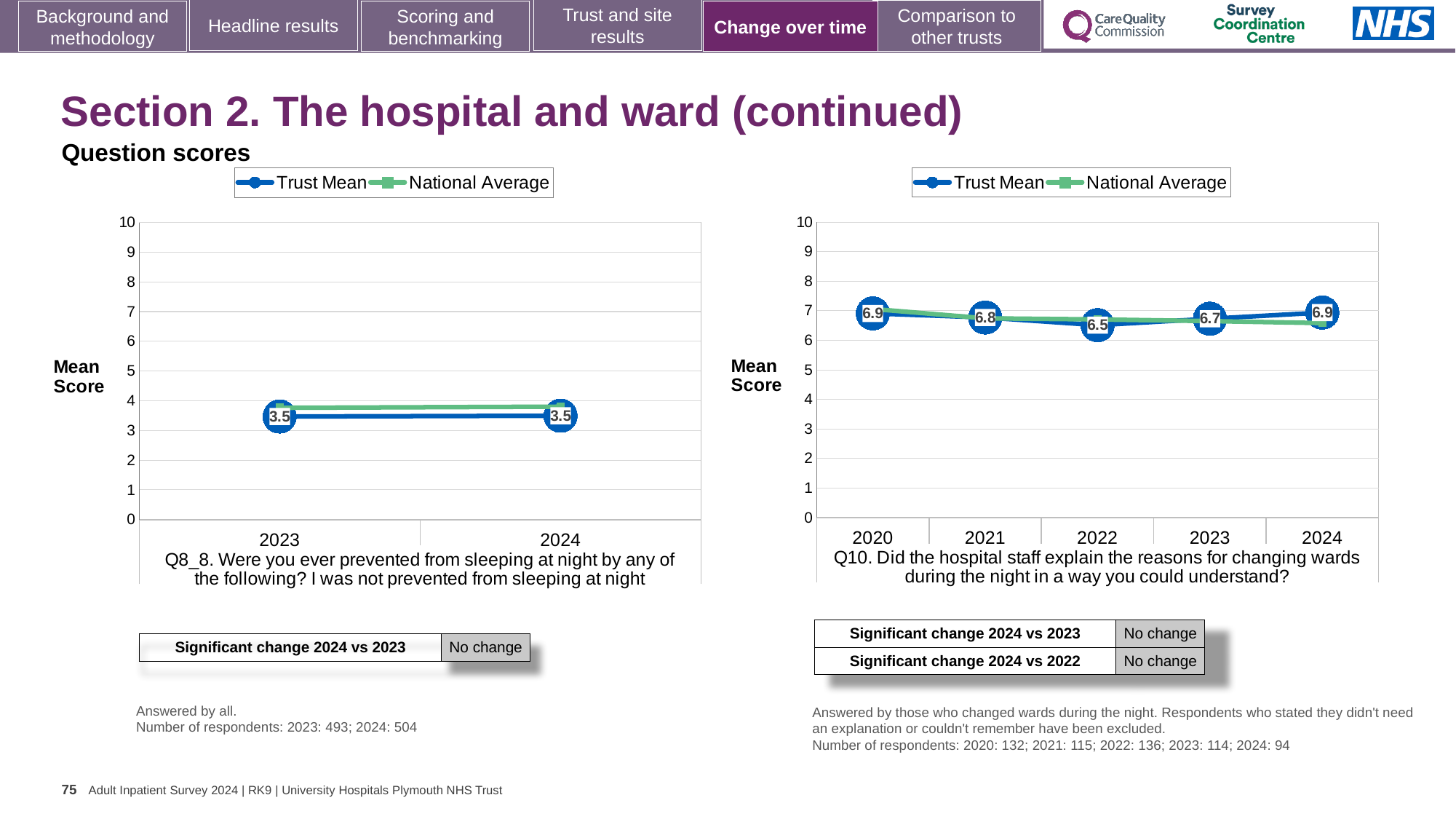
In the right chart (Q10), which year has the lowest Trust Mean score? 2022 In the left chart (Q8_8), what is the Trust Mean score for 2023? 3.5 What kind of chart is the right chart (Q10)? Line chart How many series does the legend of the left chart (Q8_8) list? 2 In the left chart (Q8_8), what is the Trust Mean score for 2024? 3.5 How many years are plotted on the x axis of the right chart (Q10)? 5 In the left chart (Q8_8), is the National Average value for 2024 greater or less than 3? greater In the right chart (Q10), what is the difference between the Trust Mean scores for 2024 and 2022? 0.4 In the right chart (Q10), is the Trust Mean score higher in 2021 or in 2022? 2021 In the right chart (Q10), is the National Average value for 2022 greater or less than 7? less In the right chart (Q10), what is the Trust Mean score for 2020? 6.9 In the right chart (Q10), what is the Trust Mean score for 2022? 6.5